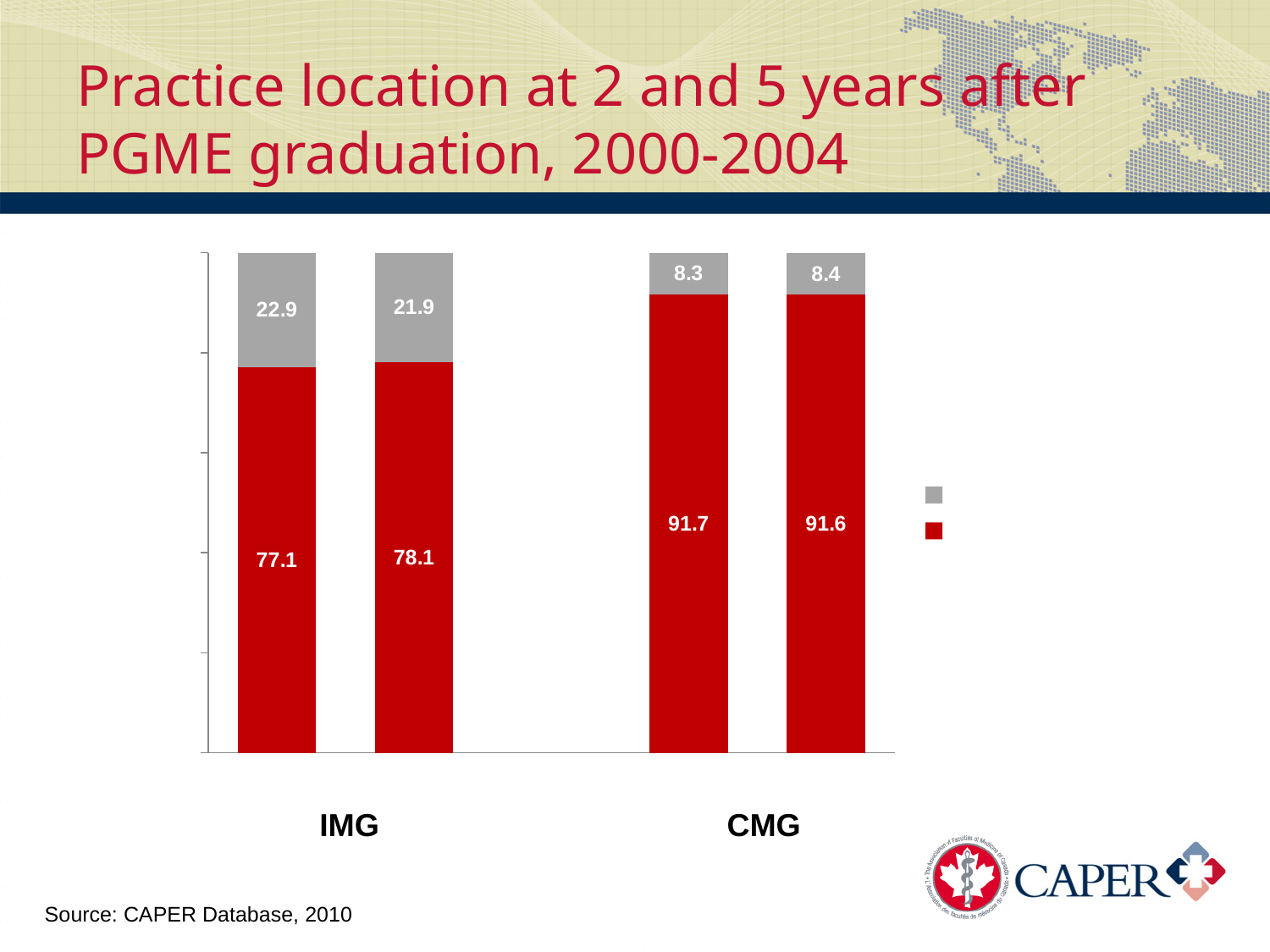
Which group, IMG or CMG, has the larger grey segment in its left bar? IMG What is the difference between the grey segments of the left and right IMG bars? 1.0 What kind of chart is shown on the slide? Stacked bar chart What is the value of the grey segment in the right IMG bar? 21.9 What is the value of the grey segment in the right CMG bar? 8.4 What is the difference between the red segment of the left CMG bar and the red segment of the left IMG bar? 14.6 What is the total of the left IMG stacked bar (red plus grey)? 100 Which group, IMG or CMG, has the larger red segments? CMG What is the value of the red segment in the left CMG bar? 91.7 How many stacked bars are plotted on the chart? 4 How many series does the legend list? 2 What is the value of the red segment in the left IMG bar? 77.1